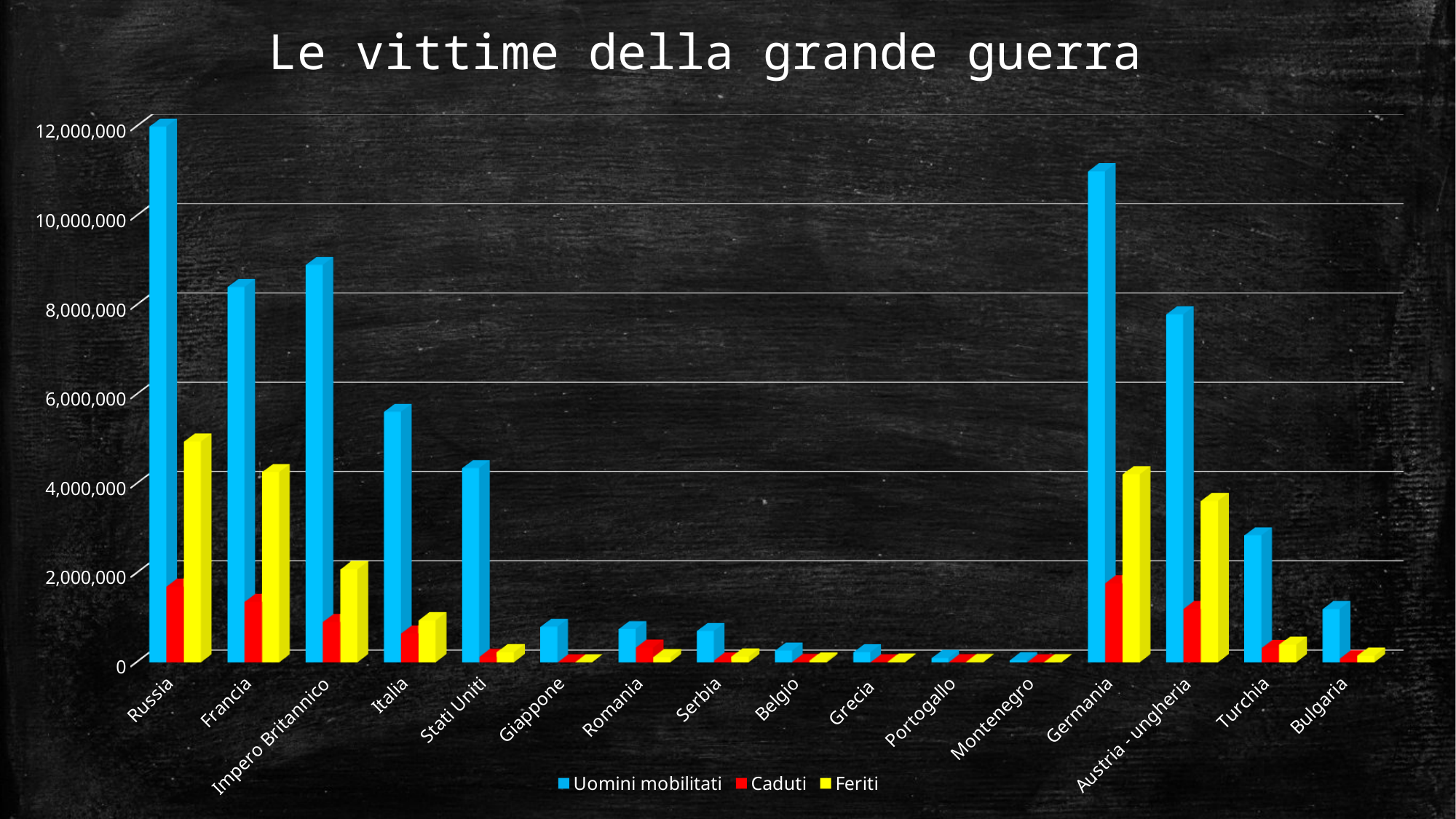
Which country has the highest value for Feriti? Russia What kind of chart is shown on the slide? bar chart Which has the larger Uomini mobilitati value, Impero Britannico or Francia? Impero Britannico How many series does the legend list? 3 How many countries are shown on the x axis of the chart? 16 Which has the larger Feriti value, Russia or Francia? Russia Is the Uomini mobilitati value for Turchia greater or less than 2,000,000? greater Is the Uomini mobilitati value for Francia greater or less than 8,000,000? greater Which country has the highest value for Uomini mobilitati? Russia Is the Uomini mobilitati value for Italia greater or less than 6,000,000? less What is the title of the chart? Le vittime della grande guerra